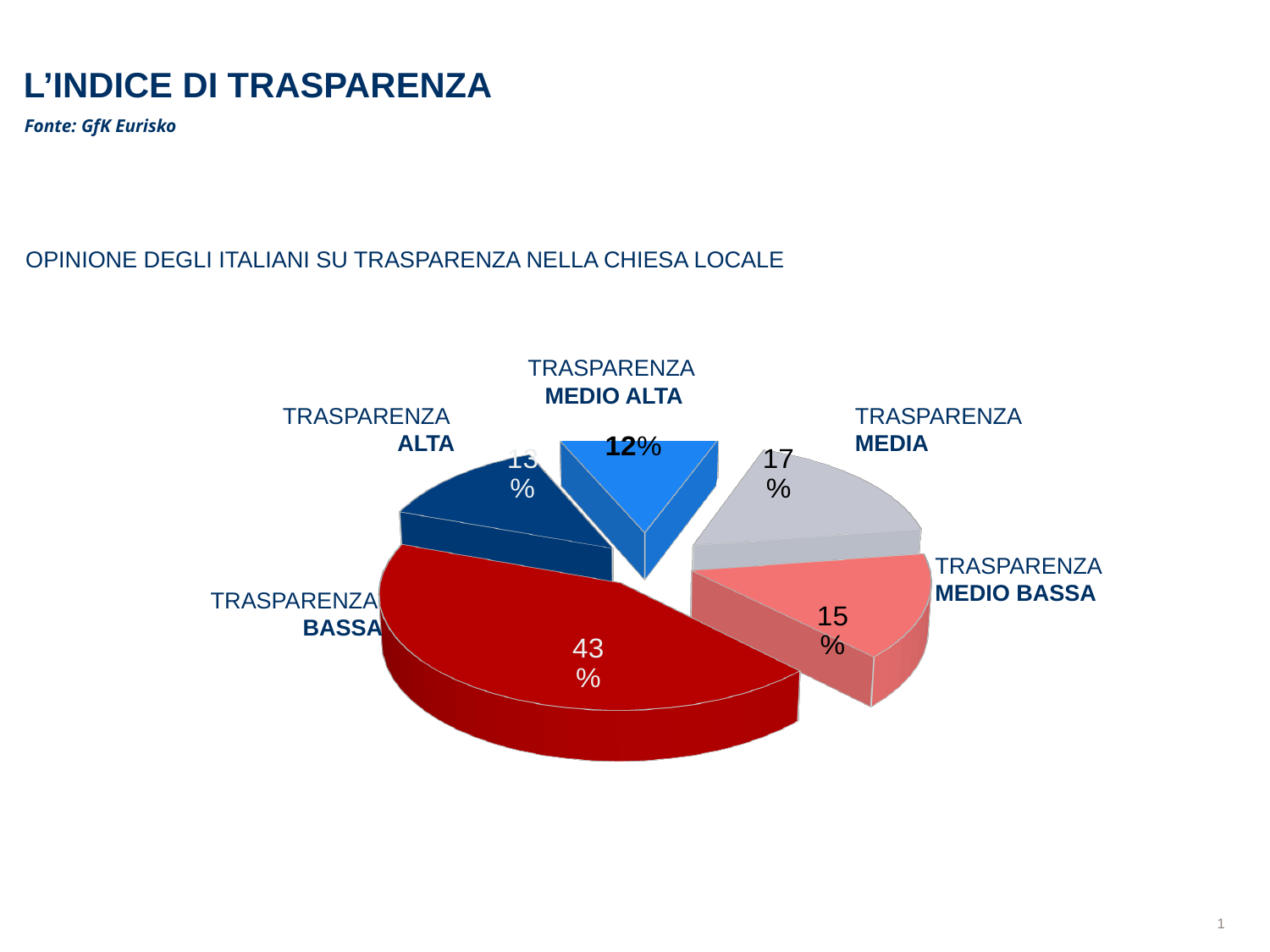
What is the value for TRASPARENZA MEDIA? 17% What colour is the TRASPARENZA BASSA slice? red What kind of chart is shown on the slide? pie chart What is the value for TRASPARENZA MEDIO ALTA? 12% Which is larger, TRASPARENZA MEDIA or TRASPARENZA MEDIO BASSA? TRASPARENZA MEDIA What is the value for TRASPARENZA MEDIO BASSA? 15% Which category has the smallest slice of the pie? TRASPARENZA MEDIO ALTA Which category has the largest slice of the pie? TRASPARENZA BASSA What is the difference between TRASPARENZA BASSA and TRASPARENZA MEDIA? 26% What percentage of Italians rate the local church's transparency as TRASPARENZA BASSA? 43% What is the combined share of TRASPARENZA MEDIO BASSA and TRASPARENZA BASSA? 58% How many slices does the pie chart have? 5